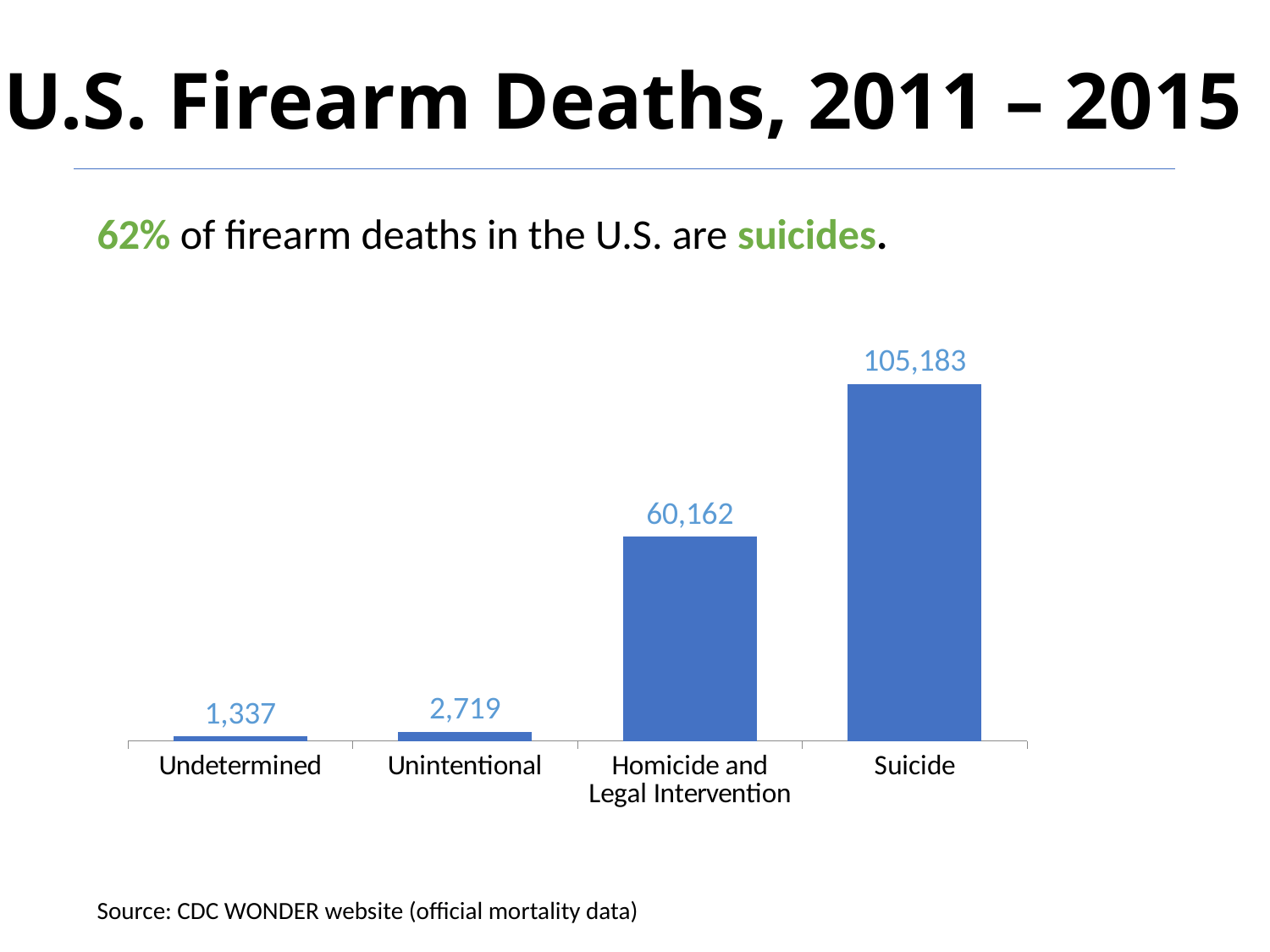
What is the difference between the values for Unintentional and Undetermined? 1,382 What is the value for Unintentional? 2,719 What is the value for Homicide and Legal Intervention? 60,162 What is the difference between the values for Suicide and Homicide and Legal Intervention? 45,021 How many categories are shown in the chart? 4 Which category has the lowest value? Undetermined What is the value for Suicide? 105,183 According to the slide, what percentage of firearm deaths in the U.S. are suicides? 62% What kind of chart is shown on the slide? Bar chart Which category has the highest value? Suicide What is the value for Undetermined? 1,337 Which is larger, the value for Unintentional or the value for Undetermined? Unintentional